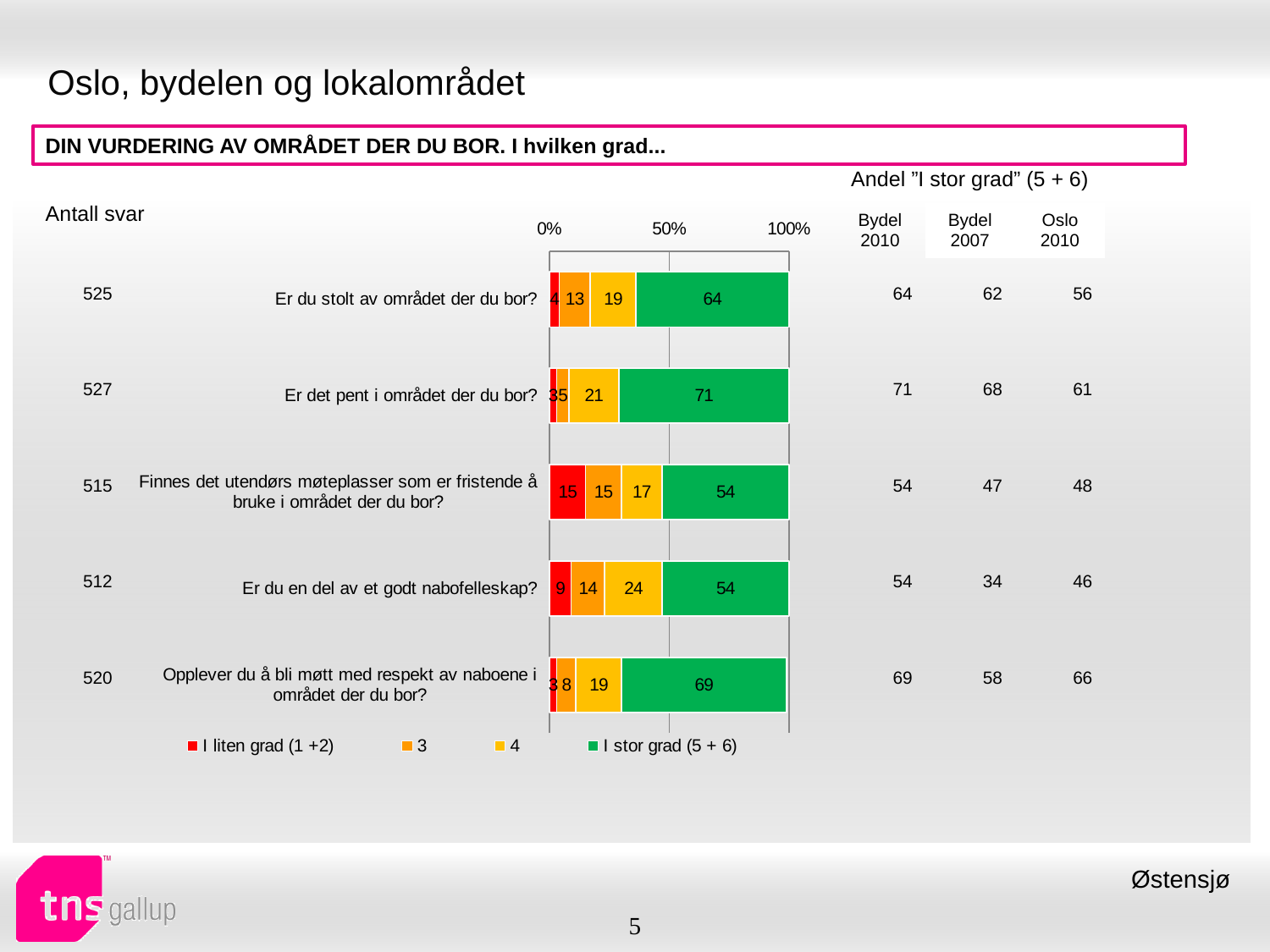
What colour represents 'I stor grad (5 + 6)' in the chart? green What is the total of the stacked bar for 'Er du en del av et godt nabofelleskap?'? 101 What is the value of series '4' for 'Er du en del av et godt nabofelleskap?'? 24 What kind of chart is shown on the slide? stacked bar chart How many categories (questions) are plotted in the chart? 5 How many series does the chart legend list? 4 What is the difference between the 'I stor grad (5 + 6)' values for 'Er det pent i området der du bor?' and 'Er du stolt av området der du bor?'? 7 What is the value of 'I liten grad (1 +2)' for 'Finnes det utendørs møteplasser som er fristende å bruke i området der du bor?'? 15 Which is larger: the 'I stor grad (5 + 6)' value for 'Opplever du å bli møtt med respekt av naboene i området der du bor?' or for 'Er du stolt av området der du bor?'? Opplever du å bli møtt med respekt av naboene i området der du bor? Which category has the highest value for 'I stor grad (5 + 6)'? Er det pent i området der du bor? Which category has the highest value for 'I liten grad (1 +2)'? Finnes det utendørs møteplasser som er fristende å bruke i området der du bor? What is the value of 'I stor grad (5 + 6)' for 'Er det pent i området der du bor?'? 71